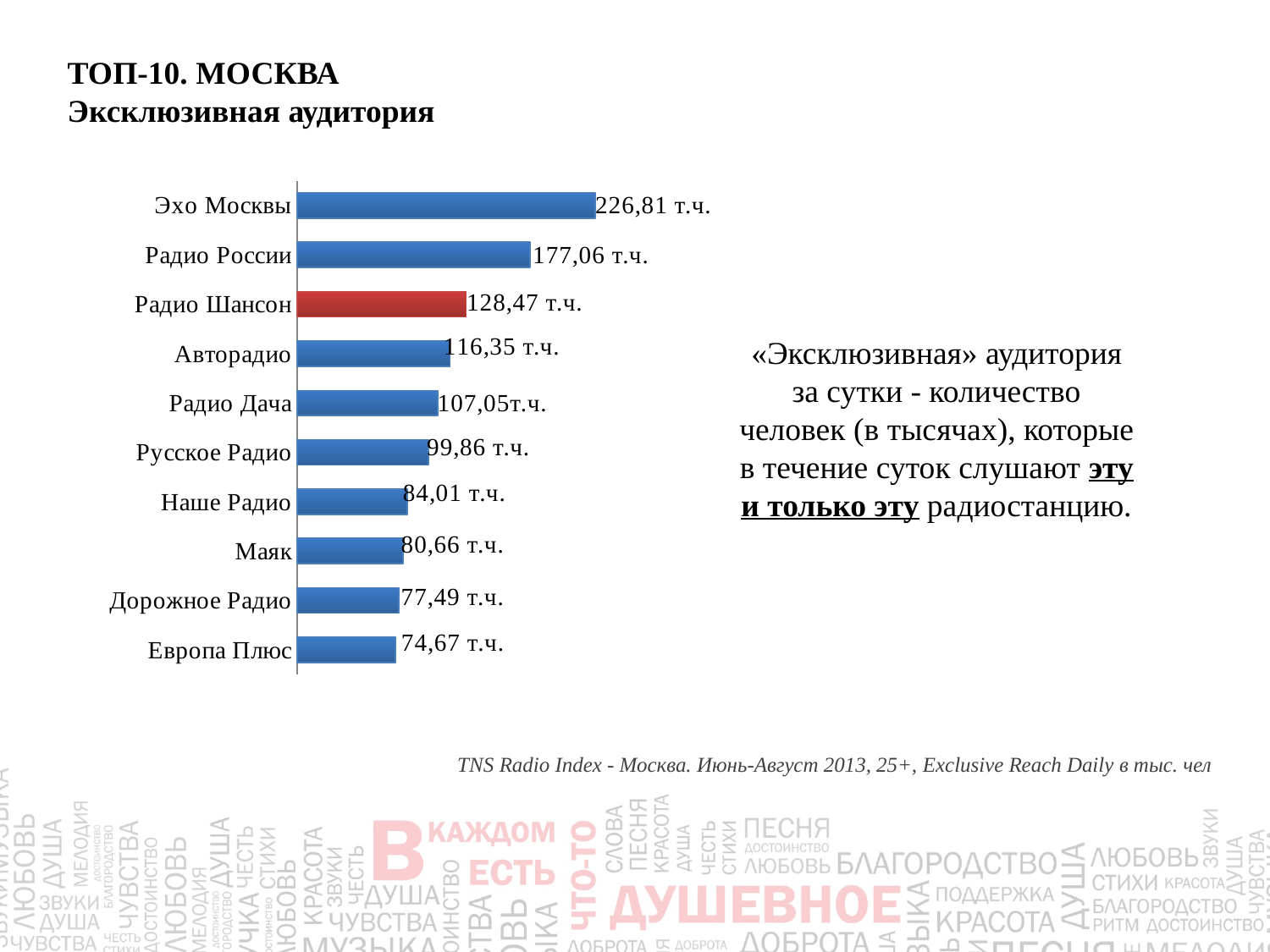
How many radio stations are shown in the chart? 10 What is the difference between the values for Радио Шансон and Авторадио? 12,12 т.ч. What is the value for Эхо Москвы? 226,81 т.ч. What is the value for Русское Радио? 99,86 т.ч. Which radio station has the lowest value? Европа Плюс What kind of chart is shown on the slide? Bar chart Which radio station's bar is coloured red instead of blue? Радио Шансон What is the difference between the values for Эхо Москвы and Радио России? 49,75 т.ч. What is the value for Европа Плюс? 74,67 т.ч. Which has a larger value, Наше Радио or Маяк? Наше Радио What is the value for Радио Шансон? 128,47 т.ч. Which radio station has the highest value? Эхо Москвы